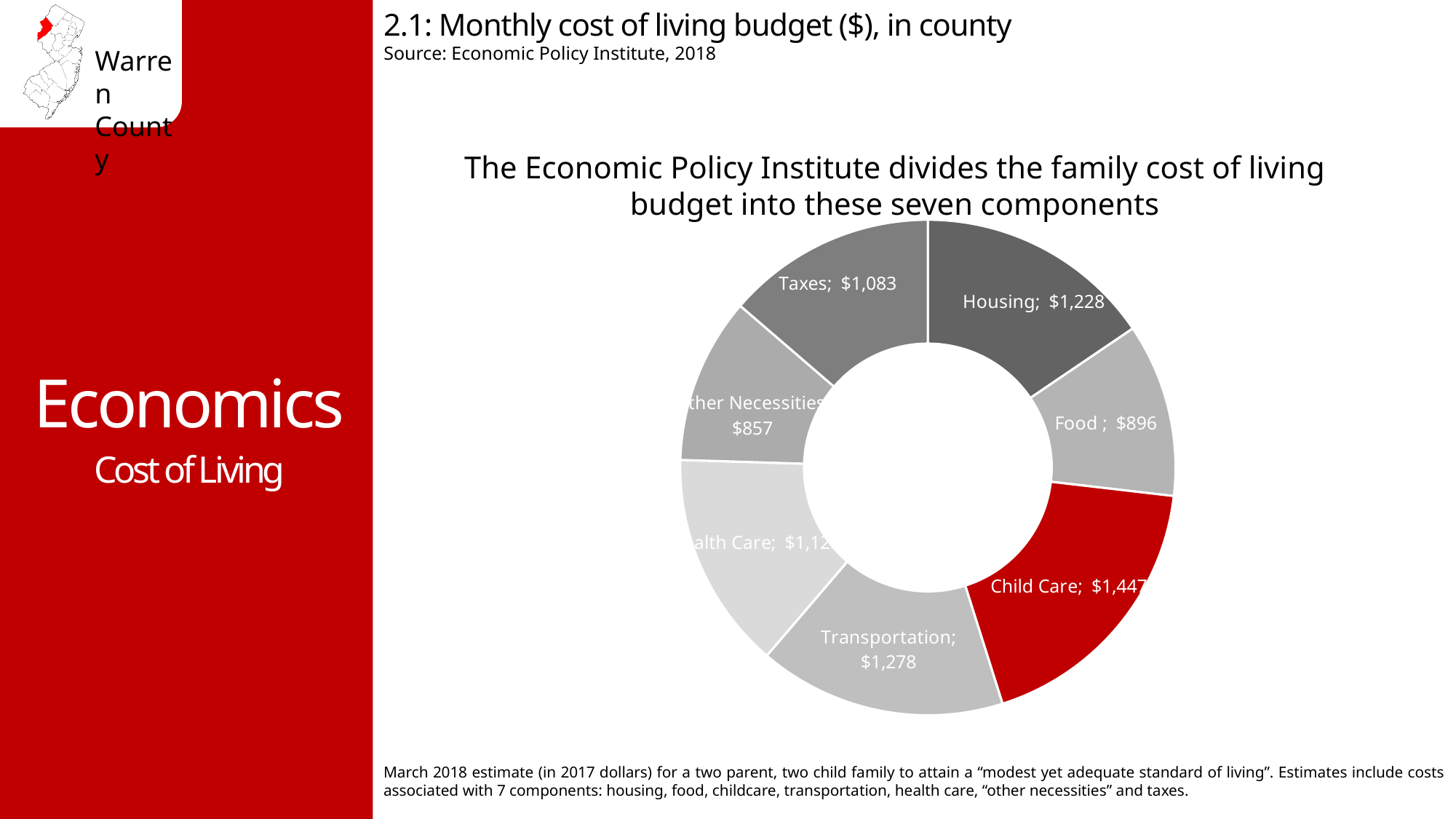
How many components are shown in the chart? 7 What is the monthly cost for Transportation? $1,278 What is the monthly cost for Food? $896 Which is larger, the Transportation cost or the Taxes cost? Transportation What is the difference between the Child Care cost and the Housing cost? $219 What is the monthly cost for Housing? $1,228 What is the monthly cost for Other Necessities? $857 Which component is shown in red on the chart? Child Care Which component has the highest monthly cost? Child Care What kind of chart is shown on the slide? Pie (doughnut) chart What is the monthly cost for Child Care? $1,447 What is the monthly cost for Taxes? $1,083